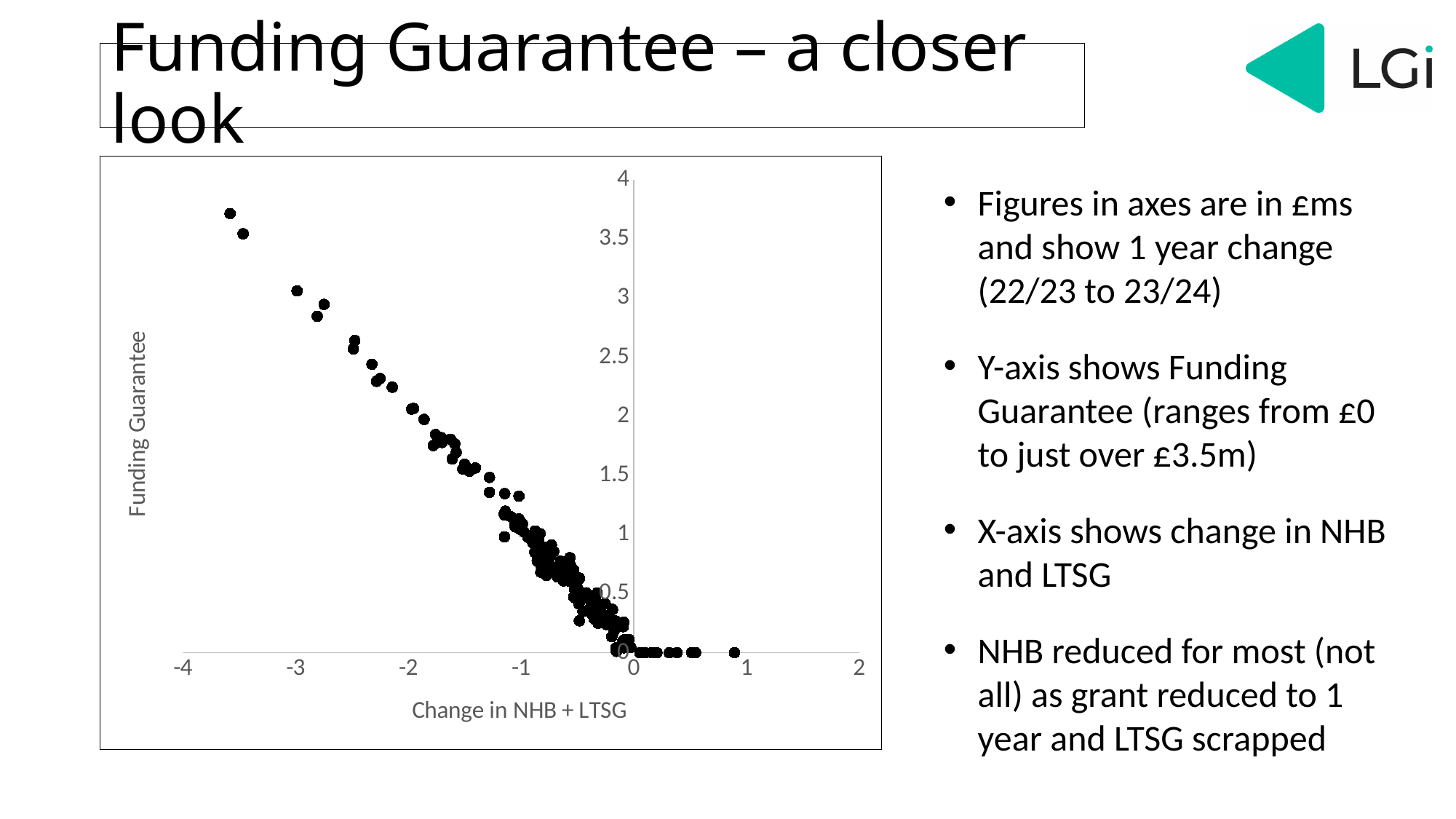
What is the title of the y axis of the chart? Funding Guarantee As the change in NHB + LTSG increases along the x axis, does the Funding Guarantee rise or fall? Fall Is the highest Funding Guarantee value plotted greater or less than 3.5? greater What kind of chart is shown on the slide? Scatter chart Is the Funding Guarantee for the points near a change of -2 greater or less than 3? less Is the Funding Guarantee for the points with a positive change in NHB + LTSG greater or less than 0.5? less What is the title of the x axis of the chart? Change in NHB + LTSG